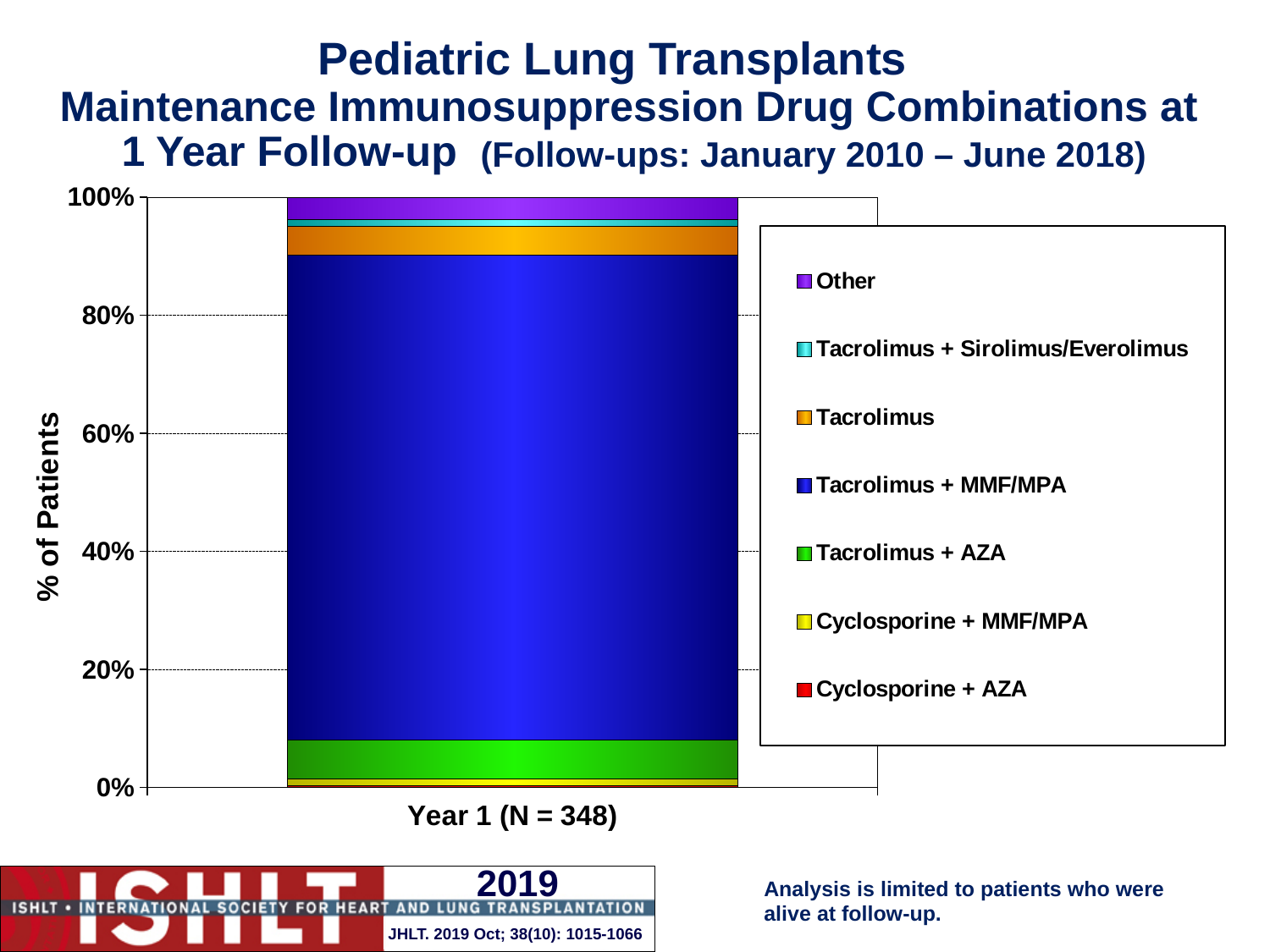
Which drug combination accounts for the largest share of the Year 1 bar? Tacrolimus + MMF/MPA Which is larger in the Year 1 bar: Tacrolimus or Tacrolimus + Sirolimus/Everolimus? Tacrolimus Is the share for Tacrolimus + AZA greater or less than 20%? less How many series does the legend list? 7 Is the share for Other greater or less than 20%? less Is the share for Tacrolimus + MMF/MPA greater or less than 60%? greater What is the label of the y axis? % of Patients How many bars (categories) are plotted on the x axis? 1 What kind of chart is shown on the slide? stacked bar chart Which is larger in the Year 1 bar: Tacrolimus + AZA or Tacrolimus + MMF/MPA? Tacrolimus + MMF/MPA What is the N value shown in the x-axis label? 348